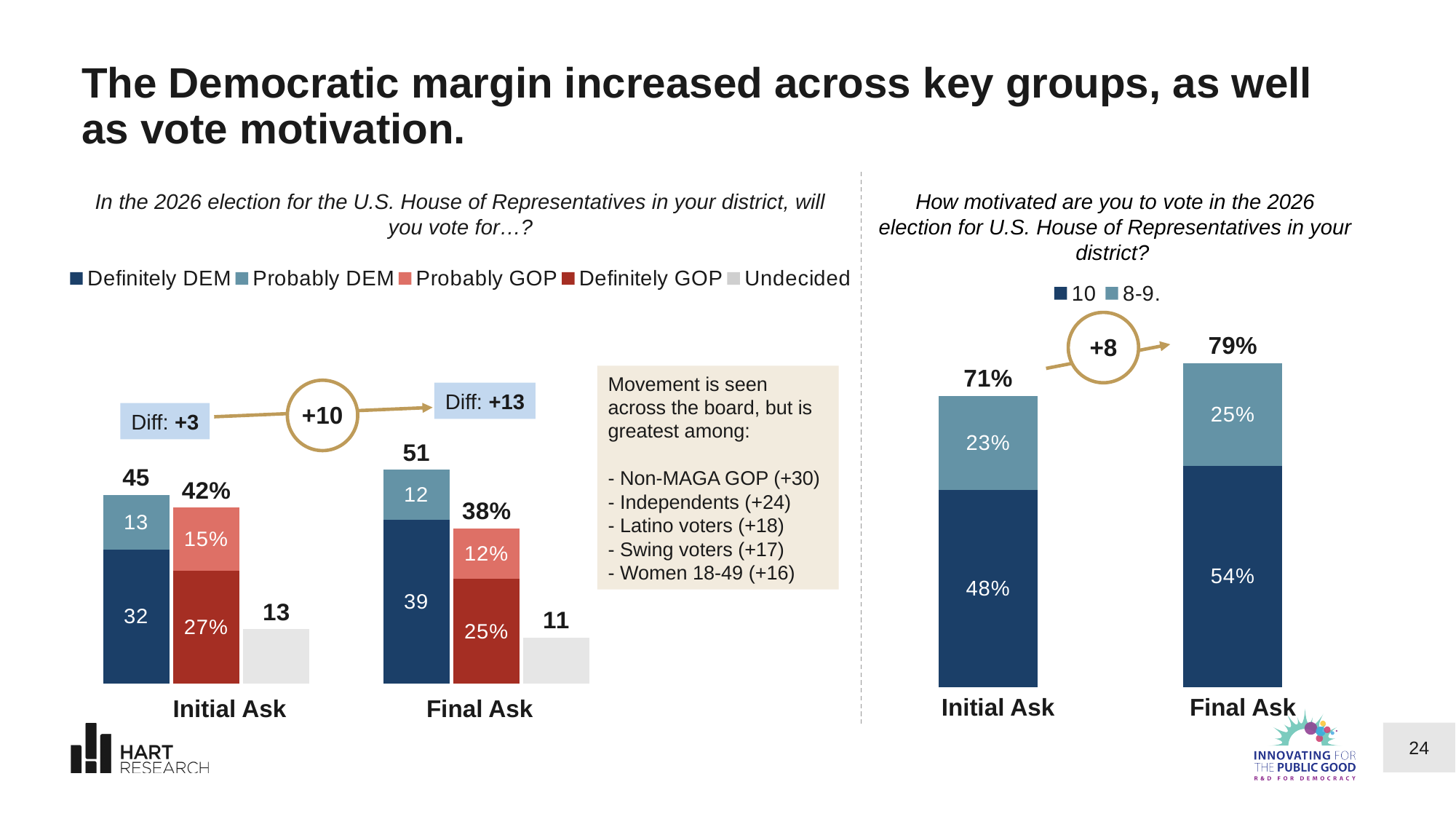
In the left chart on vote choice, what is the value for Undecided at the Initial Ask? 13 In the right chart on vote motivation, what is the difference between the 8-9 values at the Final Ask and the Initial Ask? 2 In the left chart on vote choice, what is the value for Probably GOP at the Final Ask? 12% In the left chart on vote choice, what is the difference between the Definitely DEM values at the Final Ask and the Initial Ask? 7 What kind of chart is the right chart on vote motivation? Stacked bar chart In the left chart on vote choice, what is the value for Definitely DEM at the Initial Ask? 32 In the left chart on vote choice, how many series does the legend list? 5 In the left chart on vote choice, is the Definitely GOP value larger at the Initial Ask or the Final Ask? Initial Ask In the right chart on vote motivation, what is the total of the stacked bar at the Initial Ask? 71% In the right chart on vote motivation, do the stacked totals rise or fall from the Initial Ask to the Final Ask? Rise In the right chart on vote motivation, what is the value for 10 at the Final Ask? 54% In the left chart on vote choice, what is the total of the stacked DEM bar at the Final Ask? 51